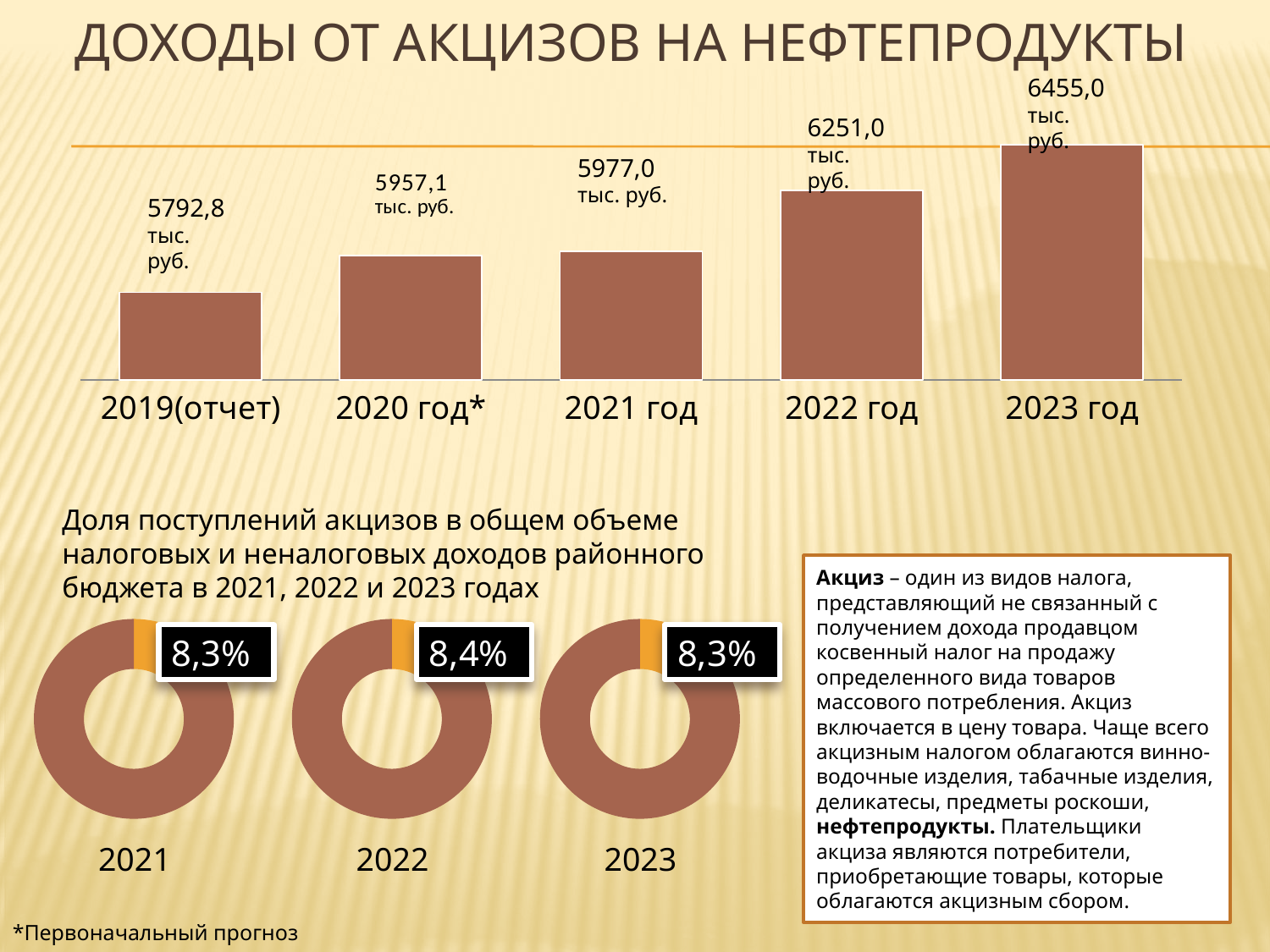
In the bar chart, do the values rise or fall from 2019 to 2023? rise In the donut charts at the bottom, what share is shown for 2022? 8,4% How many bars are in the bar chart? 5 In the bar chart, what is the difference between the values for 2022 год and 2021 год? 274,0 тыс. руб. In the bar chart, what is the value for 2020 год*? 5957,1 тыс. руб. In the bar chart, which year has the highest value? 2023 год In the bar chart, which year has the lowest value? 2019(отчет) In the bar chart, what is the difference between the values for 2023 год and 2019(отчет)? 662,2 тыс. руб. In the bar chart, which is larger: the value for 2019(отчет) or the value for 2022 год? 2022 год In the bar chart, what is the value for 2022 год? 6251,0 тыс. руб. What kind of chart is the top chart on the slide? bar chart In the bar chart, what is the value for 2019(отчет)? 5792,8 тыс. руб.